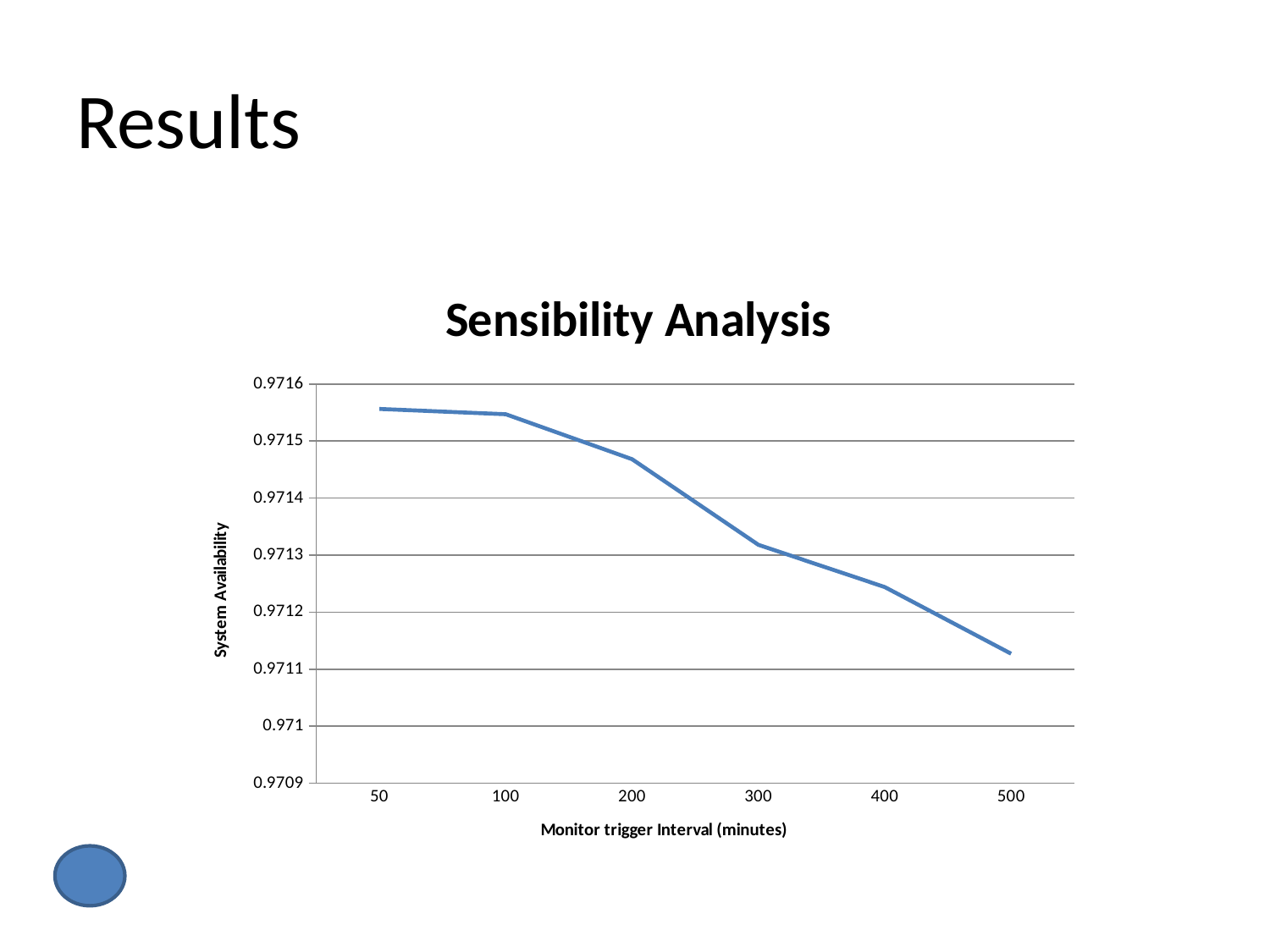
Does system availability rise or fall as the monitor trigger interval increases? fall At which monitor trigger interval is system availability lowest? 500 Which has the higher system availability, a trigger interval of 200 or 400 minutes? 200 How many data points are plotted on the line? 6 What is the title of the chart? Sensibility Analysis What is the label of the x axis? Monitor trigger Interval (minutes) At which monitor trigger interval is system availability highest? 50 Is the system availability at a trigger interval of 50 minutes greater or less than 0.9715? greater What kind of chart is shown on the slide? line chart Is the system availability at a trigger interval of 300 minutes greater or less than 0.9714? less Is the system availability at a trigger interval of 500 minutes greater or less than 0.9712? less